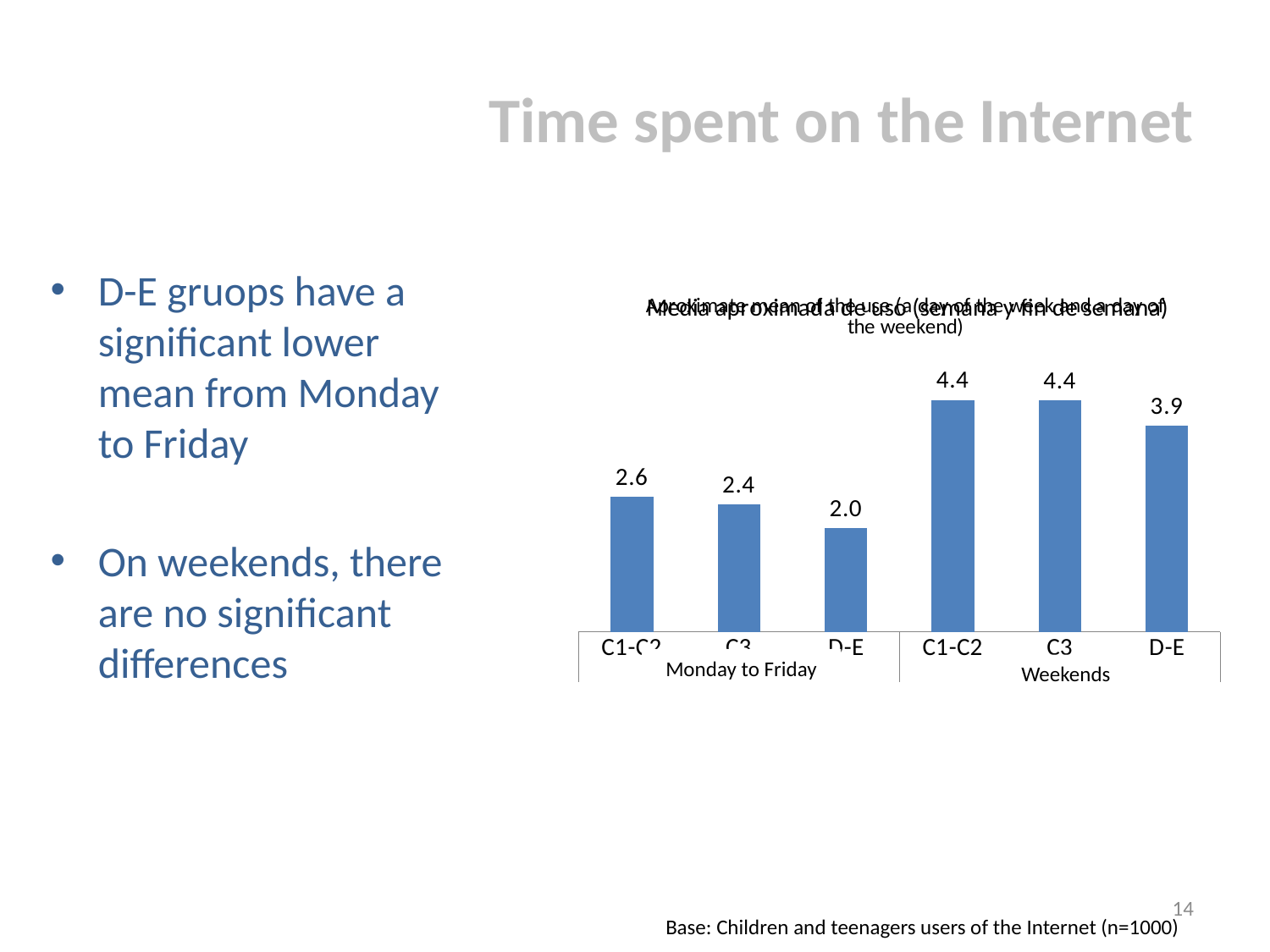
Which bar has the lowest value in the chart? D-E (Monday to Friday) What is the value for D-E in the Weekends group? 3.9 Within the Monday to Friday group, which category has the highest value? C1-C2 What kind of chart is shown on the slide? Bar chart What is the value for C3 in the Monday to Friday group? 2.4 How many bars are plotted in the chart? 6 What is the value for D-E in the Monday to Friday group? 2.0 What is the difference between the C1-C2 value on Weekends and the C1-C2 value Monday to Friday? 1.8 Within the Weekends group, which category has the lowest value? D-E What is the difference between the C1-C2 and D-E values in the Monday to Friday group? 0.6 Which is larger: the D-E value on Weekends or the C1-C2 value Monday to Friday? D-E on Weekends What is the value for C1-C2 in the Weekends group? 4.4